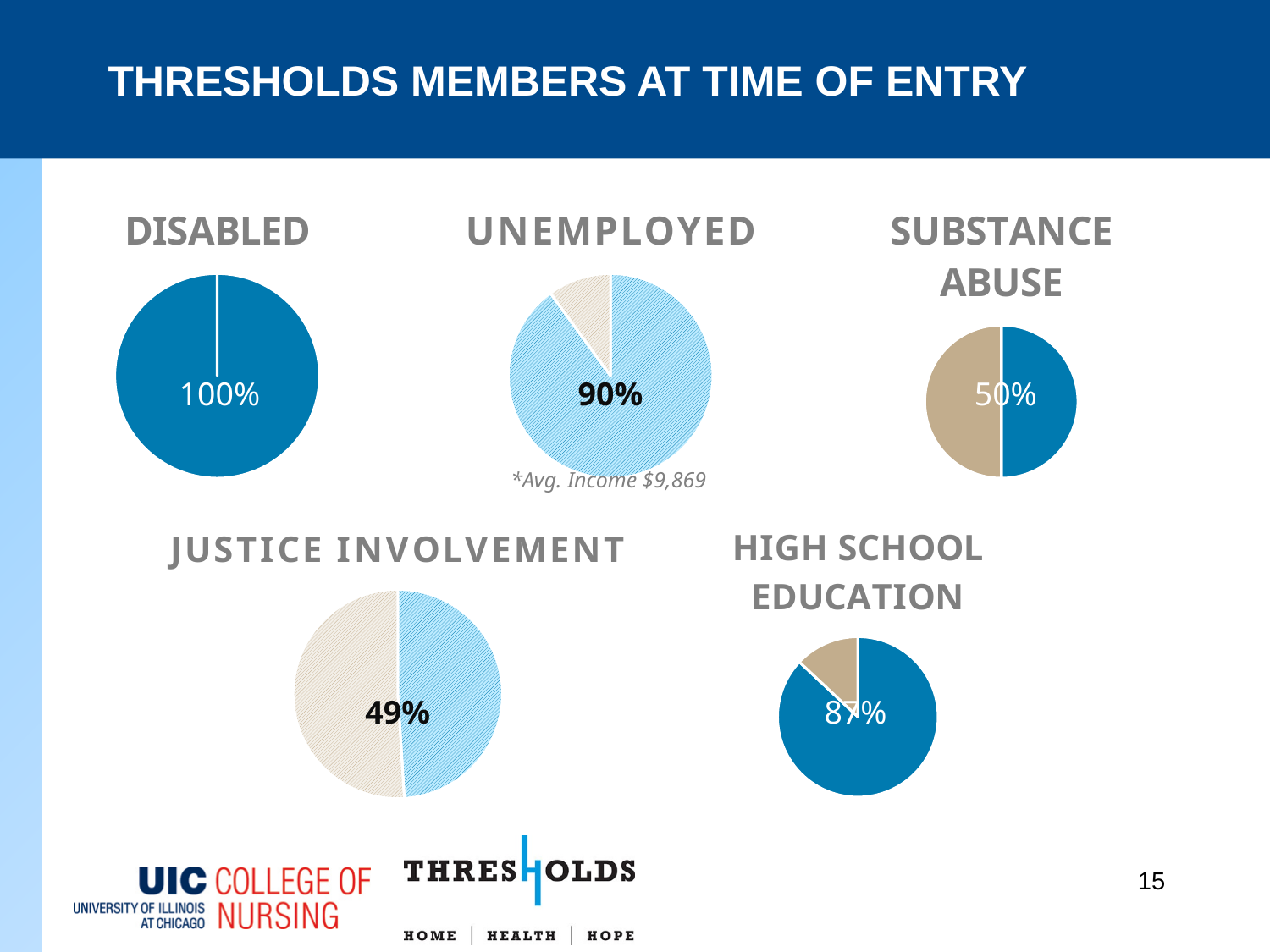
How many pie charts are on the slide? 5 What percentage is shown on the Unemployed pie chart? 90% What percentage is shown on the Substance Abuse pie chart? 50% What is the difference between the Unemployed percentage and the Substance Abuse percentage? 40% Which is larger, the Disabled percentage or the Unemployed percentage? Disabled Which of the five pie charts shows the lowest percentage? Justice Involvement What percentage is shown on the Disabled pie chart? 100% What kind of chart is used for Justice Involvement? Pie chart What percentage is shown on the Justice Involvement pie chart? 49% What average income is noted beneath the Unemployed pie chart? $9,869 Is the value shown on the High School Education pie chart greater or less than 50%? greater Which of the five pie charts shows the highest percentage? Disabled